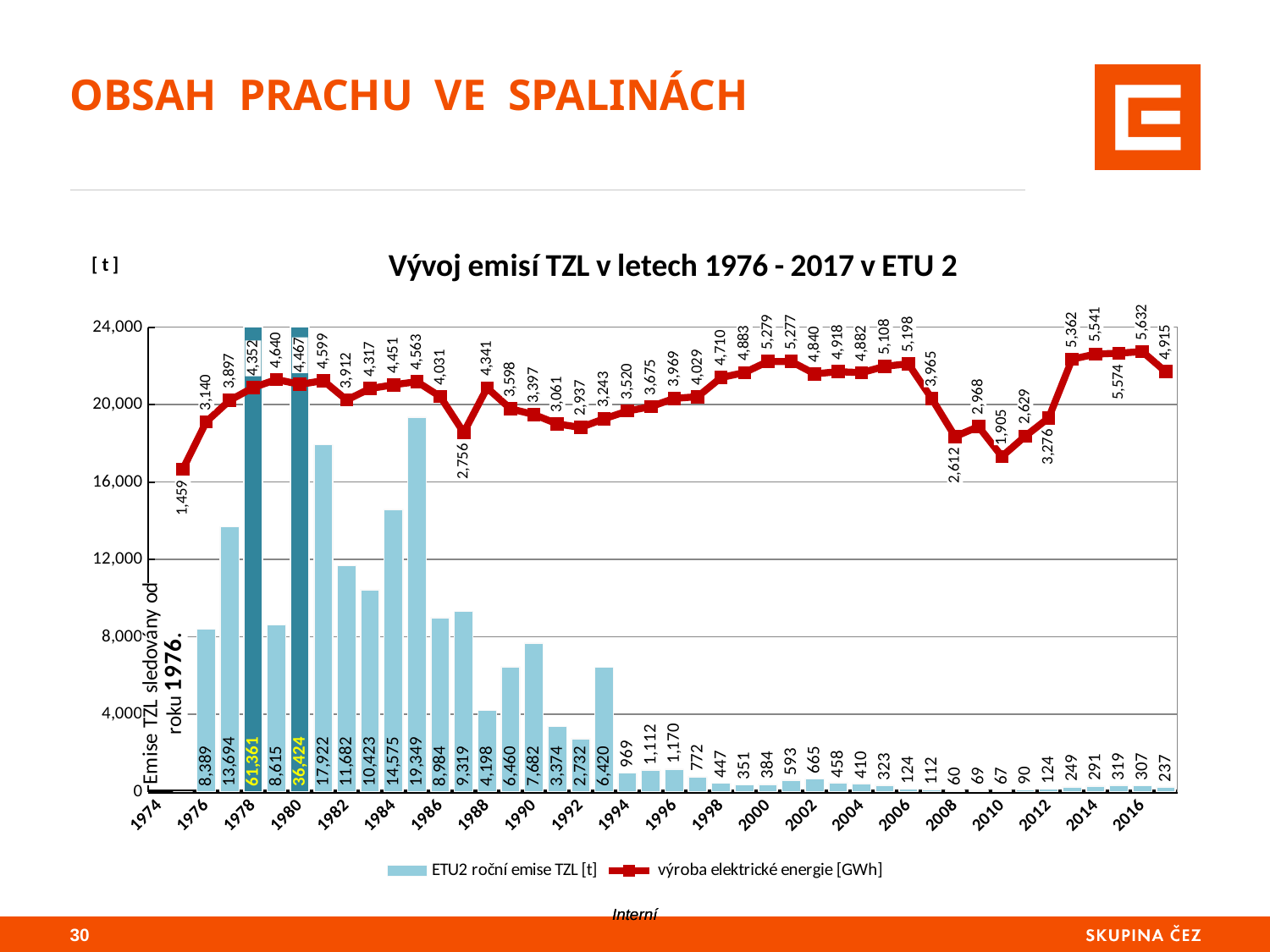
What kind of chart is shown on the slide? A combined bar and line chart Which year had higher ETU2 TZL emissions, 1981 or 1985? 1985 In which year was the ETU2 annual TZL emission highest? 1978 What was the ETU2 annual TZL emission in 1976? 8,389 What is the highest value shown for the electricity production (výroba elektrické energie) line? 5,632 What was the ETU2 annual TZL emission in 1980? 36,424 What is the difference between the ETU2 TZL emissions in 1978 and 1980? 24,937 What was the ETU2 annual TZL emission in 2017? 237 How many series does the legend list? 2 What was the ETU2 annual TZL emission in 1978? 61,361 In which year was the ETU2 annual TZL emission lowest? 2008 What is the title of the chart? Vývoj emisí TZL v letech 1976 - 2017 v ETU 2